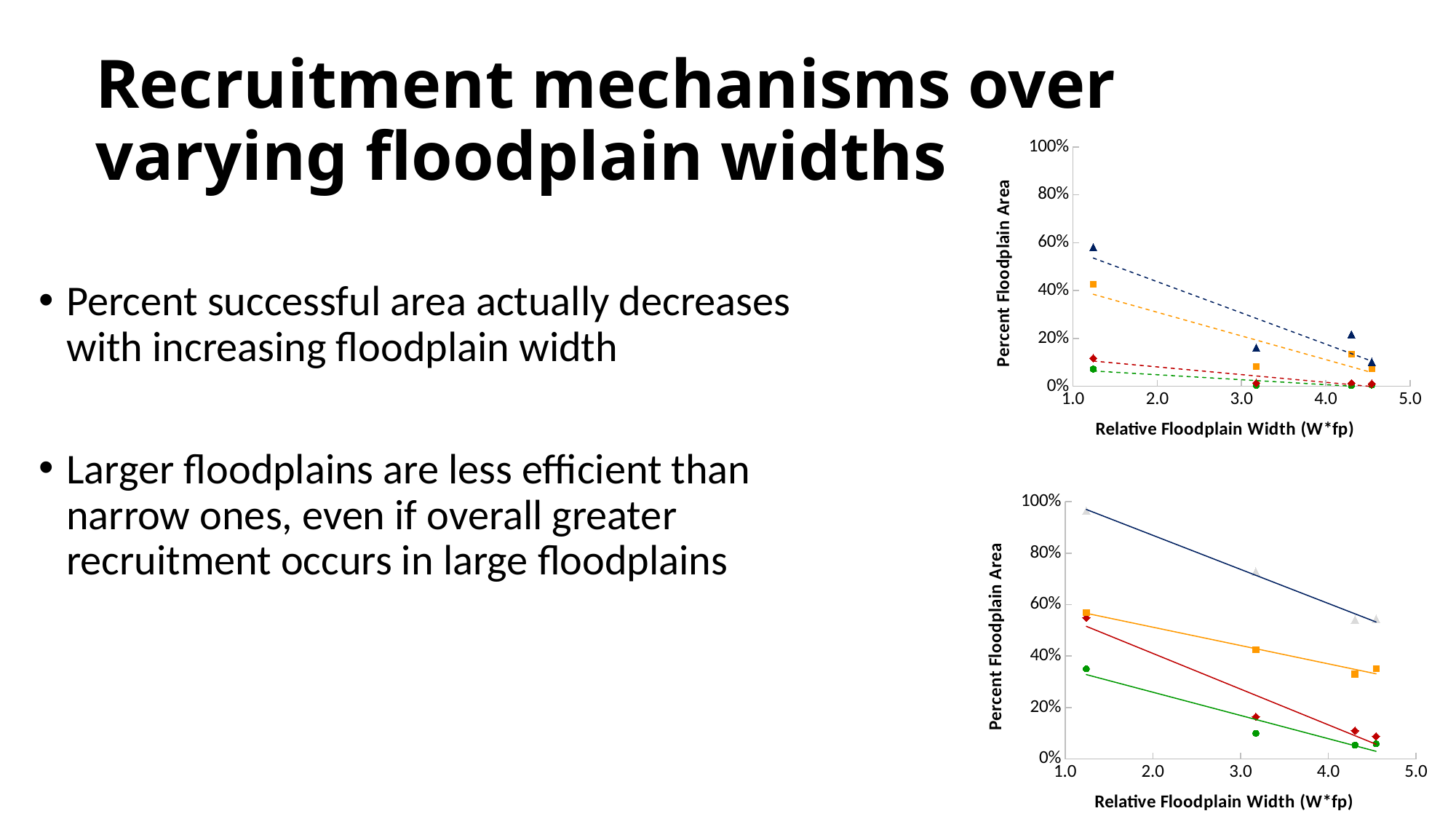
What is the y-axis title of the top chart? Percent Floodplain Area What kind of chart is the top chart on the right of the slide? Scatter chart In the bottom chart, do the plotted values rise or fall as Relative Floodplain Width increases? Fall In the top chart, is the value of the blue triangle point at the smallest floodplain width greater or less than 40%? greater In the bottom chart, is the value of the green circle point near a floodplain width of 3.0 greater or less than 20%? less What kind of chart is the bottom chart on the right of the slide? Scatter chart In the top chart, which marker series has the lowest values across all floodplain widths? Green circles In the top chart, do the plotted values rise or fall as Relative Floodplain Width increases? Fall In the bottom chart, is the value of the blue triangle point at the smallest floodplain width greater or less than 80%? greater In the bottom chart, which marker series has the highest values across all floodplain widths? Blue triangles In the bottom chart, at the smallest floodplain width, which is larger: the blue triangle value or the green circle value? Blue triangle What is the x-axis title of the bottom chart? Relative Floodplain Width (W*fp)